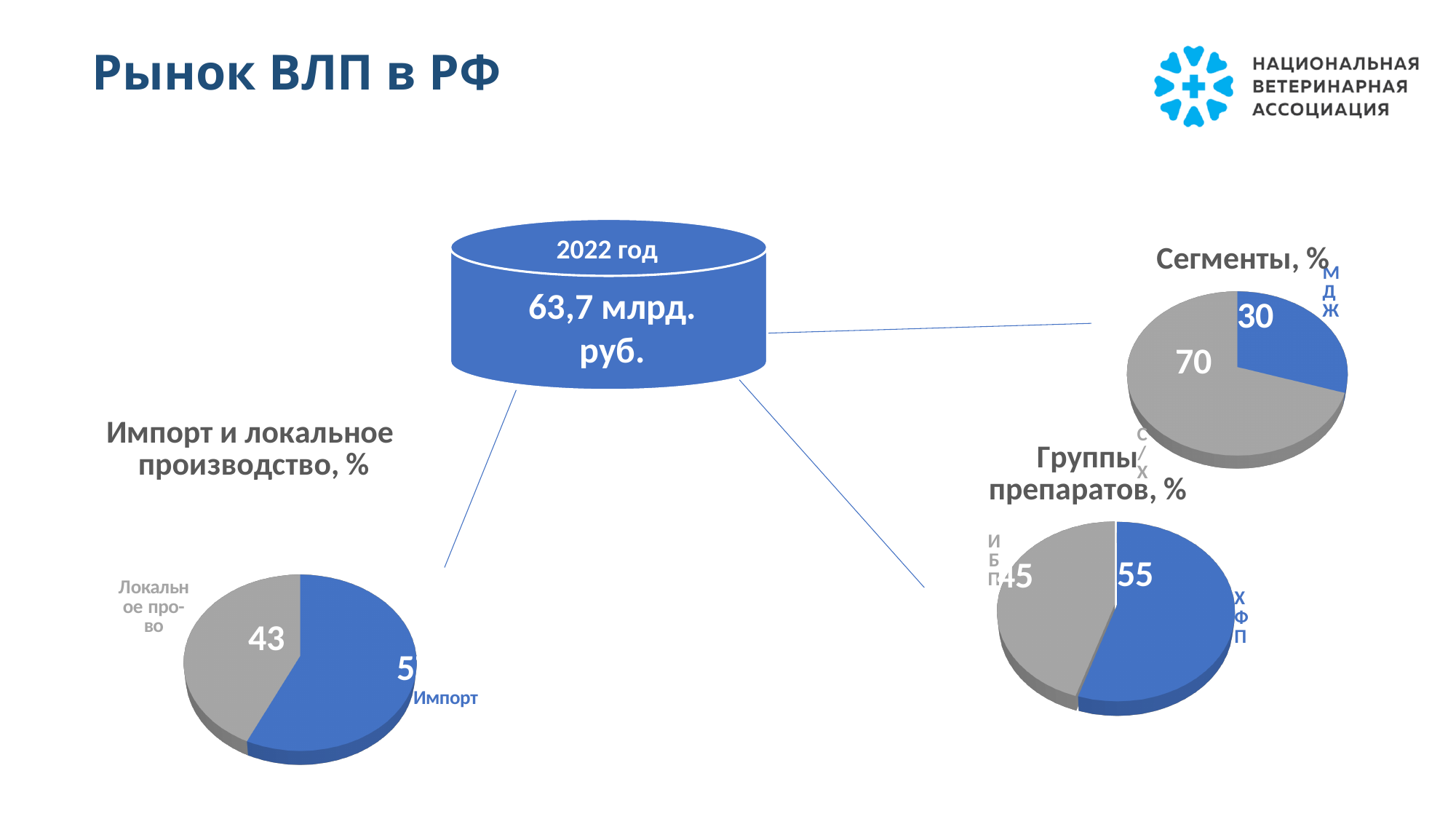
In the "Сегменты, %" chart, which segment is larger, МДЖ or С/Х? С/Х In the "Сегменты, %" chart, what is the value for МДЖ? 30 In the "Группы препаратов, %" chart, what is the value for ИБП? 45 In the "Сегменты, %" chart, what is the value for С/Х? 70 In the "Группы препаратов, %" chart, what is the difference between the ХФП and ИБП values? 10 In the "Сегменты, %" chart, what is the difference between the С/Х and МДЖ values? 40 In the "Группы препаратов, %" chart, what is the value for ХФП? 55 In the "Группы препаратов, %" chart, which group has the larger share? ХФП In the "Импорт и локальное производство, %" chart, what is the value for Локальное про-во? 43 How many slices does the "Группы препаратов, %" pie chart have? 2 What kind of chart is used for "Сегменты, %"? Pie chart In the "Импорт и локальное производство, %" chart, which slice is larger, Импорт or Локальное про-во? Импорт